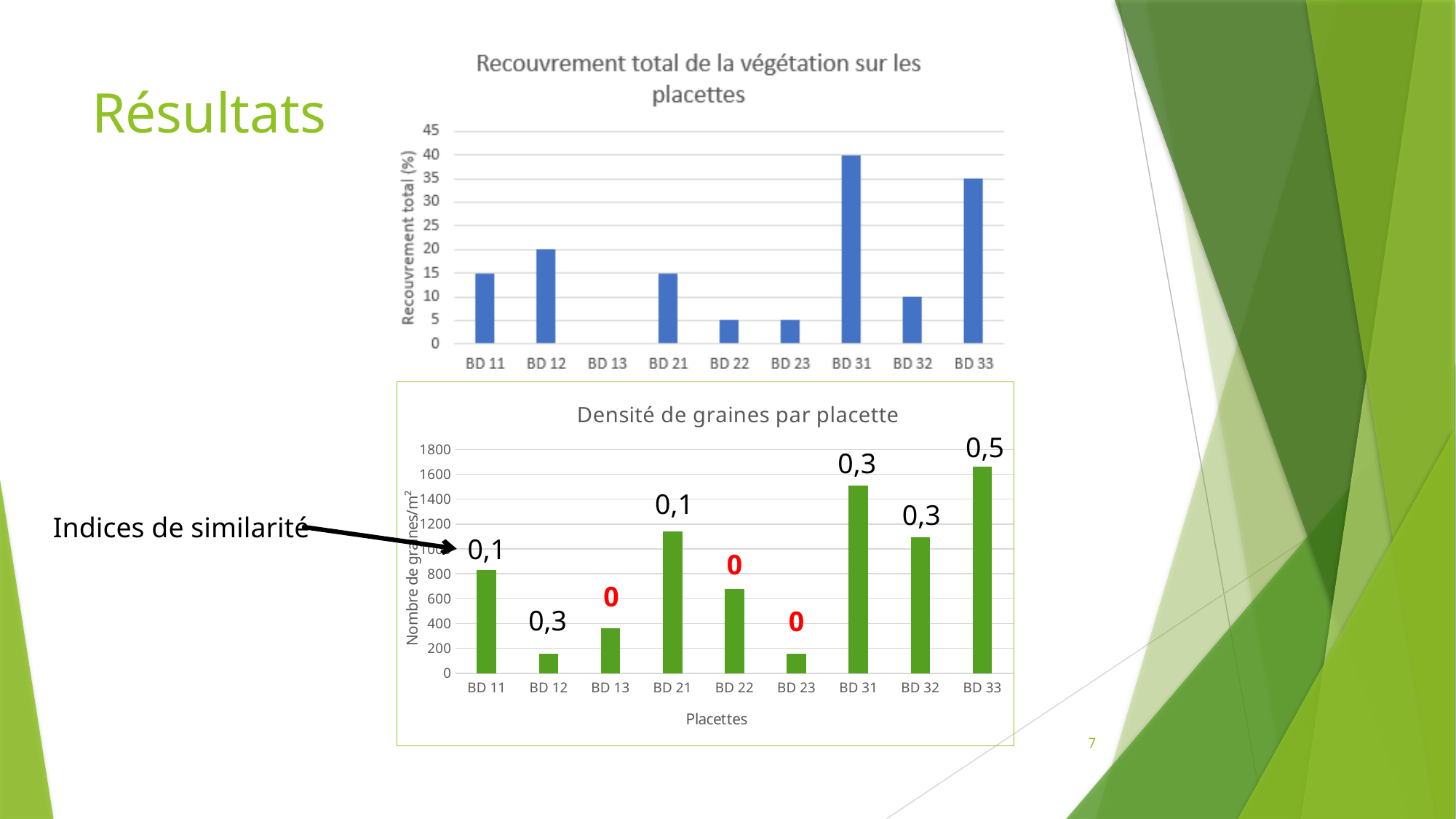
In the chart 'Recouvrement total de la végétation sur les placettes', how many placettes are shown on the x axis? 9 In the chart 'Densité de graines par placette', is the value for BD 12 greater or less than 200? less In the chart 'Densité de graines par placette', is the value for BD 33 greater or less than 1600? greater What kind of chart is 'Densité de graines par placette'? bar chart In the chart 'Densité de graines par placette', which placette has the highest number of seeds per m²? BD 33 In the chart 'Recouvrement total de la végétation sur les placettes', which placette has the highest recouvrement total? BD 31 In the chart 'Recouvrement total de la végétation sur les placettes', what is the difference between the values for BD 31 and BD 33? 5 In the chart 'Recouvrement total de la végétation sur les placettes', what is the value for BD 12? 20 In the chart 'Recouvrement total de la végétation sur les placettes', what is the unit shown on the y axis label? % In the chart 'Recouvrement total de la végétation sur les placettes', which is larger, the value for BD 12 or the value for BD 32? BD 12 In the chart 'Densité de graines par placette', what similarity index is printed above the bar for BD 33? 0,5 In the chart 'Recouvrement total de la végétation sur les placettes', what is the value for BD 31? 40